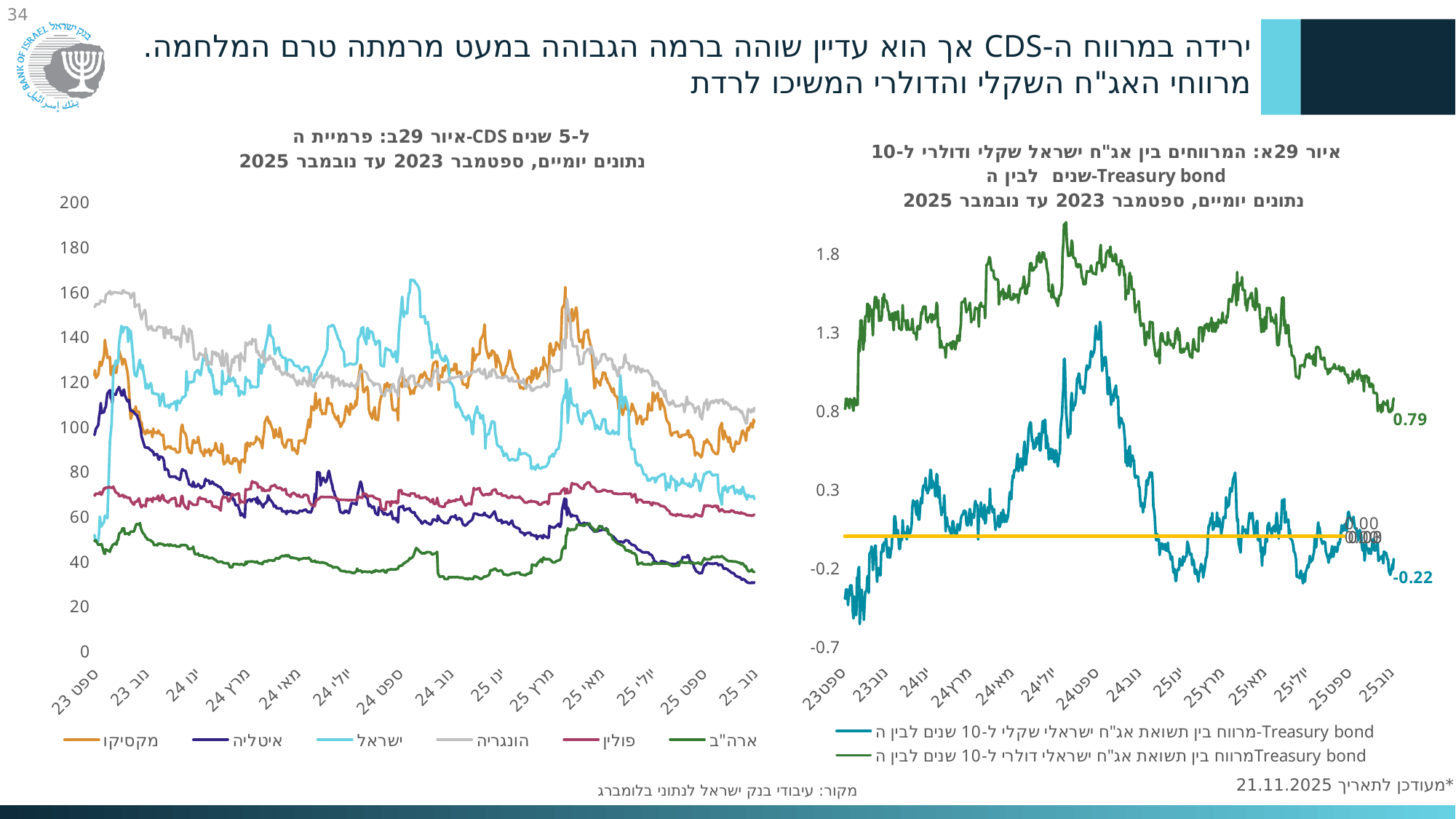
In the left chart (איור 29ב), what colour is the line for ישראל? light blue In the left chart (איור 29ב), is the CDS premium for ישראל in September 2023 greater or less than 100? less In the right chart (איור 29א), what is the final labelled value of the dollar bond spread (green line)? 0.79 In the right chart (איור 29א), what is the difference between the final dollar spread (0.79) and the final shekel spread (-0.22)? 1.01 What kind of chart is the left chart (איור 29ב, CDS premium)? line chart In the right chart (איור 29א), which series ends higher in November 2025, the shekel spread or the dollar spread? the dollar spread How many series does the legend of the left chart (איור 29ב) list? 6 In the left chart (איור 29ב), is the CDS premium for פולין in November 2025 greater or less than 80? less How many series does the legend of the right chart (איור 29א) list? 2 In the left chart (איור 29ב), which country has the highest CDS premium in September 2023? הונגריה In the right chart (איור 29א), what is the final labelled value of the shekel bond spread (teal line)? -0.22 In the right chart (איור 29א), does the dollar bond spread rise or fall between September 2025 and November 2025? fall